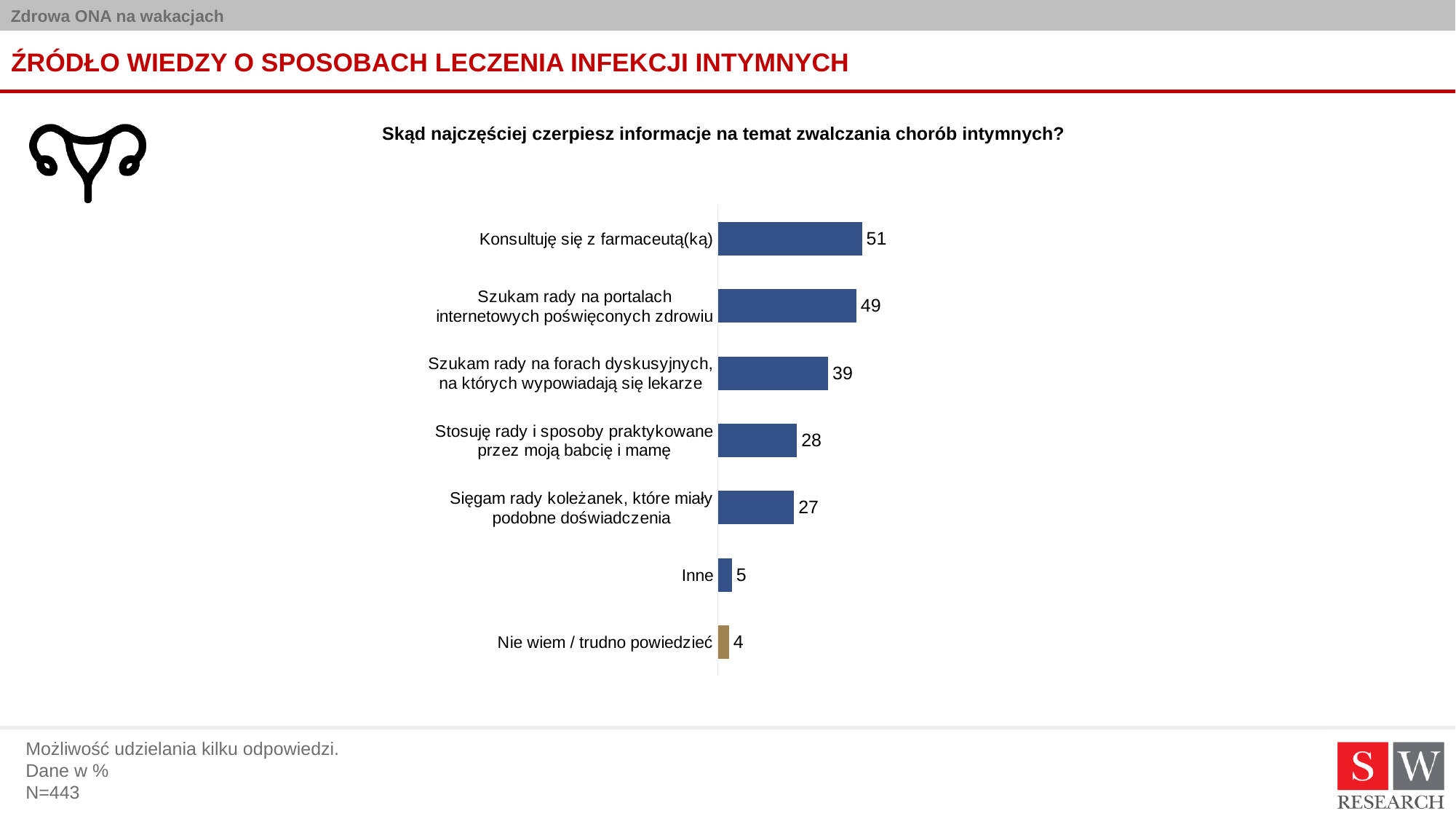
How many categories are shown in the chart? 7 What is the difference between the values for "Konsultuję się z farmaceutą(ką)" and "Szukam rady na portalach internetowych poświęconych zdrowiu"? 2 What value is shown for "Inne"? 5 What kind of chart is shown on the slide? Bar chart What value is shown for "Szukam rady na forach dyskusyjnych, na których wypowiadają się lekarze"? 39 What value is shown for "Sięgam rady koleżanek, które miały podobne doświadczenia"? 27 What is the difference between the values for "Szukam rady na forach dyskusyjnych, na których wypowiadają się lekarze" and "Stosuję rady i sposoby praktykowane przez moją babcię i mamę"? 11 Which category has the highest value? Konsultuję się z farmaceutą(ką) Which is larger: the value for "Szukam rady na portalach internetowych poświęconych zdrowiu" or the value for "Szukam rady na forach dyskusyjnych, na których wypowiadają się lekarze"? Szukam rady na portalach internetowych poświęconych zdrowiu What question is shown as the chart's title? Skąd najczęściej czerpiesz informacje na temat zwalczania chorób intymnych? Which category has the lowest value? Nie wiem / trudno powiedzieć What value is shown for "Konsultuję się z farmaceutą(ką)"? 51